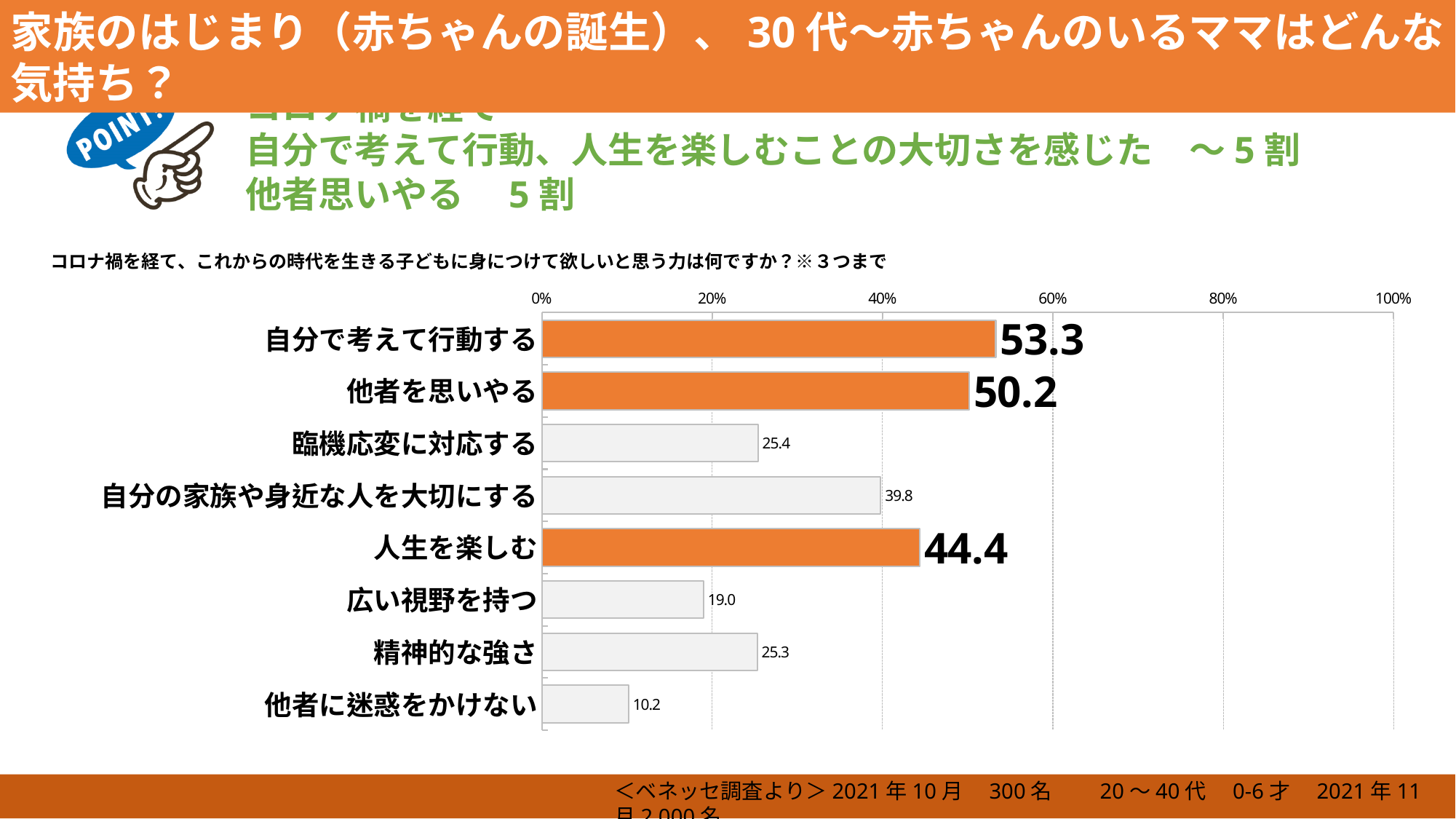
What is the value for 他者に迷惑をかけない? 10.2 What is the value for 自分で考えて行動する? 53.3 Which category has the highest value? 自分で考えて行動する What is the difference between the values for 自分で考えて行動する and 他者を思いやる? 3.1 How many bars are highlighted in orange? 3 Which is larger, the value for 自分の家族や身近な人を大切にする or 臨機応変に対応する? 自分の家族や身近な人を大切にする What kind of chart is shown on the slide? bar chart How many categories are shown in the chart? 8 What is the value for 他者を思いやる? 50.2 Which category has the lowest value? 他者に迷惑をかけない What is the value for 人生を楽しむ? 44.4 Is the value for 広い視野を持つ greater or less than 20%? less